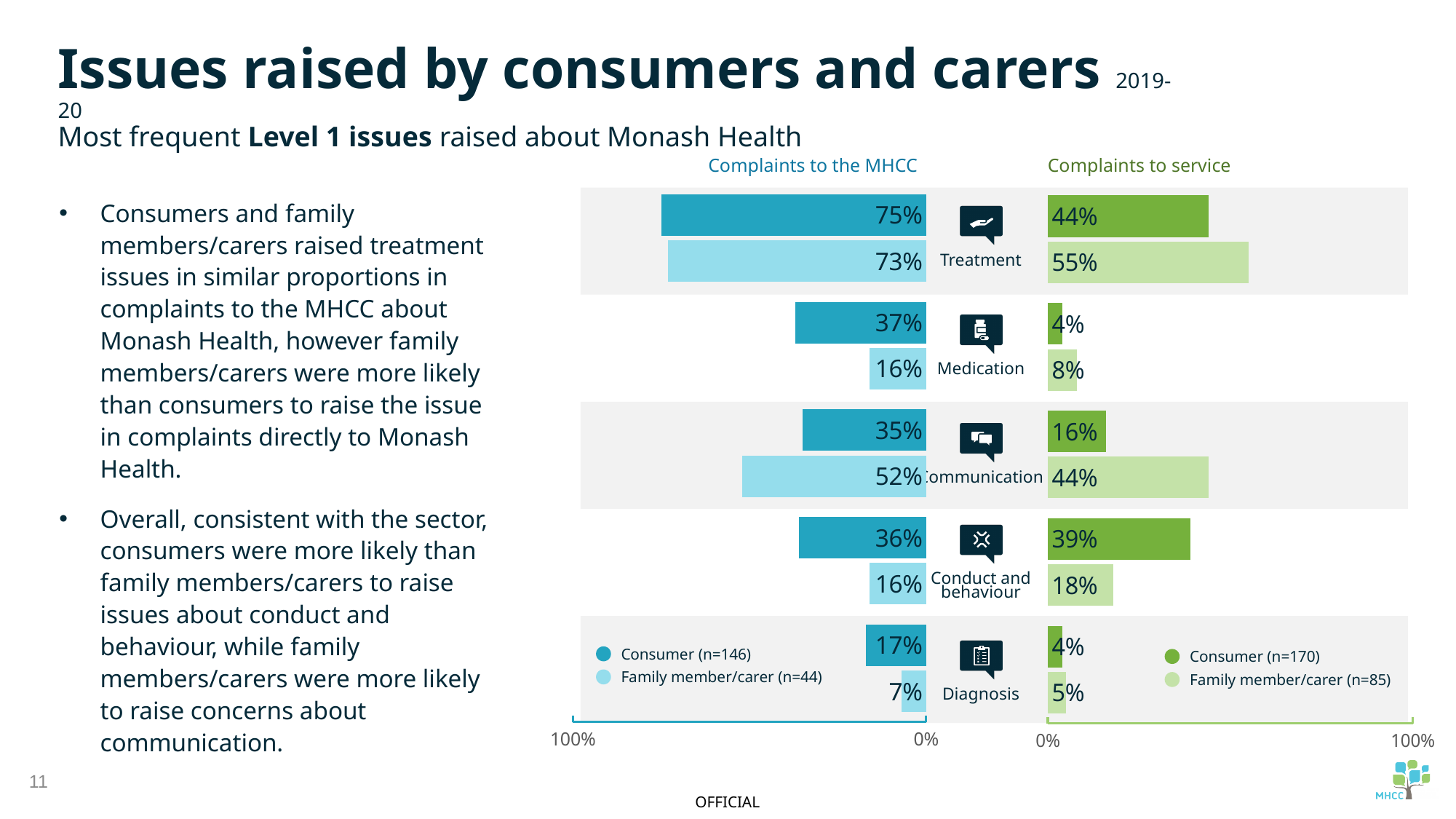
In the 'Complaints to the MHCC' chart, which is larger for Communication: the consumer percentage or the family member/carer percentage? Family member/carer How many issue categories are shown in the 'Complaints to the MHCC' chart? 5 In the 'Complaints to the MHCC' chart, which issue has the highest percentage for family member/carer complaints? Treatment In the 'Complaints to service' chart, what percentage of family member/carer complaints raised Communication issues? 44% In the 'Complaints to the MHCC' chart, what percentage of consumer complaints raised Treatment issues? 75% In the 'Complaints to the MHCC' chart, what is the difference between the consumer and family member/carer percentages for Medication? 21% In the 'Complaints to the MHCC' chart, what percentage of family member/carer complaints raised Diagnosis issues? 7% In the 'Complaints to service' chart, which is larger for Conduct and behaviour: the consumer percentage or the family member/carer percentage? Consumer In the 'Complaints to service' chart, which issue has the lowest percentage for family member/carer complaints? Diagnosis What type of chart is the 'Complaints to service' chart? Bar chart How many series does the legend of the 'Complaints to service' chart list? 2 In the 'Complaints to service' chart, what is the sample size (n) for the Consumer series shown in the legend? 170